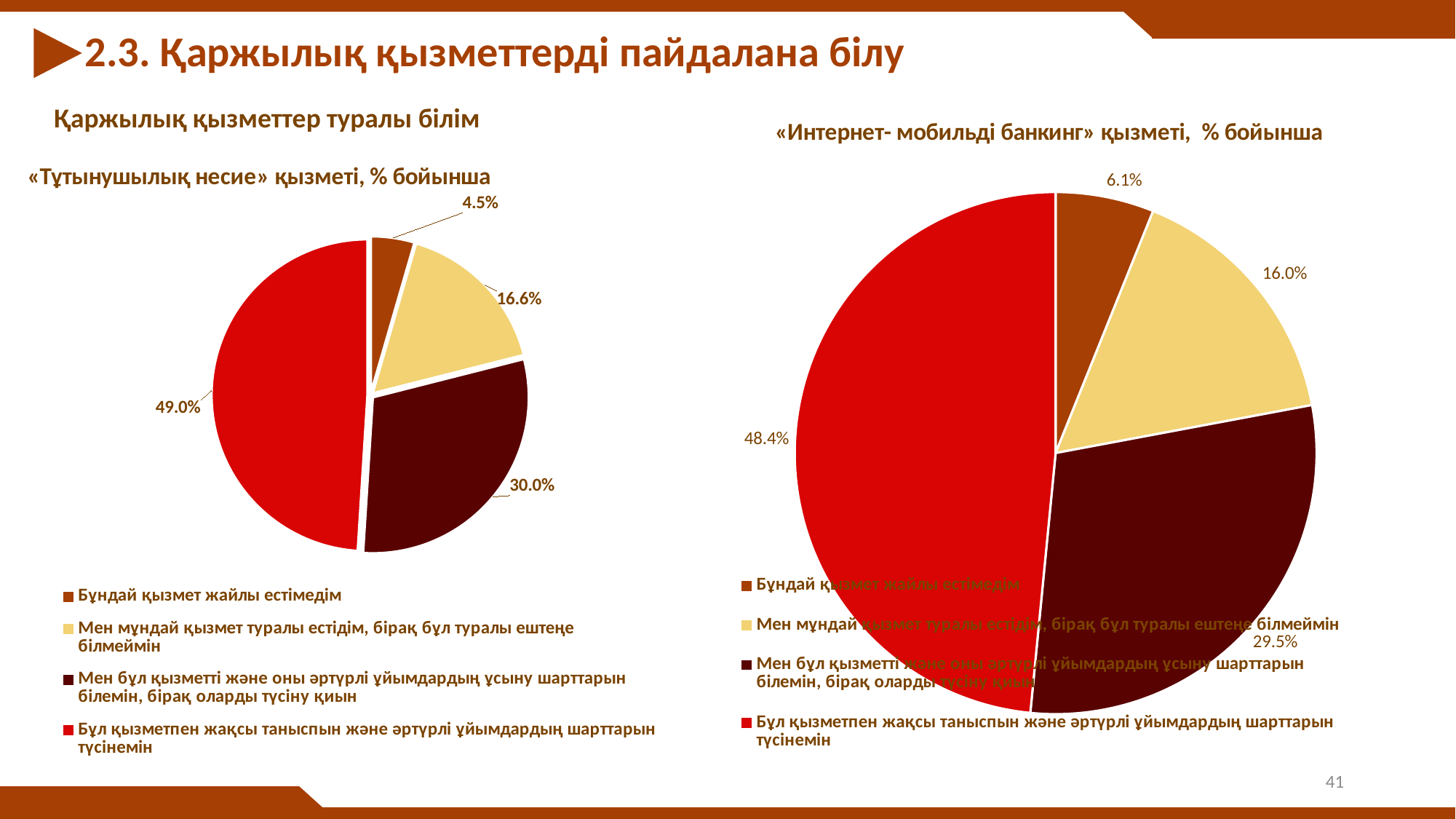
What type of chart is used for «Тұтынушылық несие» қызметі, % бойынша? Pie chart In the «Интернет- мобильді банкинг» қызметі chart, which category has the largest slice? Бұл қызметпен жақсы таныспын және әртүрлі ұйымдардың шарттарын түсінемін In the «Тұтынушылық несие» қызметі chart, what share is labelled for the «Бұндай қызмет жайлы естімедім» slice? 4.5% In the «Интернет- мобильді банкинг» қызметі chart, what share is shown for «Мен бұл қызметті және оны әртүрлі ұйымдардың ұсыну шарттарын білемін, бірақ оларды түсіну қиын»? 29.5% In the «Интернет- мобильді банкинг» қызметі chart, what share is shown for «Мен мұндай қызмет туралы естідім, бірақ бұл туралы ештеңе білмеймін»? 16.0% In the «Тұтынушылық несие» қызметі chart, what is the difference between the 49.0% slice and the 30.0% slice? 19.0% In the «Интернет- мобильді банкинг» қызметі chart, what colour is the slice for «Бұндай қызмет жайлы естімедім»? Brown In the «Тұтынушылық несие» қызметі chart, which category has the smallest slice? Бұндай қызмет жайлы естімедім In the «Тұтынушылық несие» қызметі chart, what share is shown for «Бұл қызметпен жақсы таныспын және әртүрлі ұйымдардың шарттарын түсінемін»? 49.0% Which chart shows a larger share for «Бұндай қызмет жайлы естімедім», the «Тұтынушылық несие» chart or the «Интернет- мобильді банкинг» chart? «Интернет- мобильді банкинг» chart How many slices does the «Интернет- мобильді банкинг» қызметі pie chart have? 4 How many entries does the legend of the «Тұтынушылық несие» қызметі chart list? 4